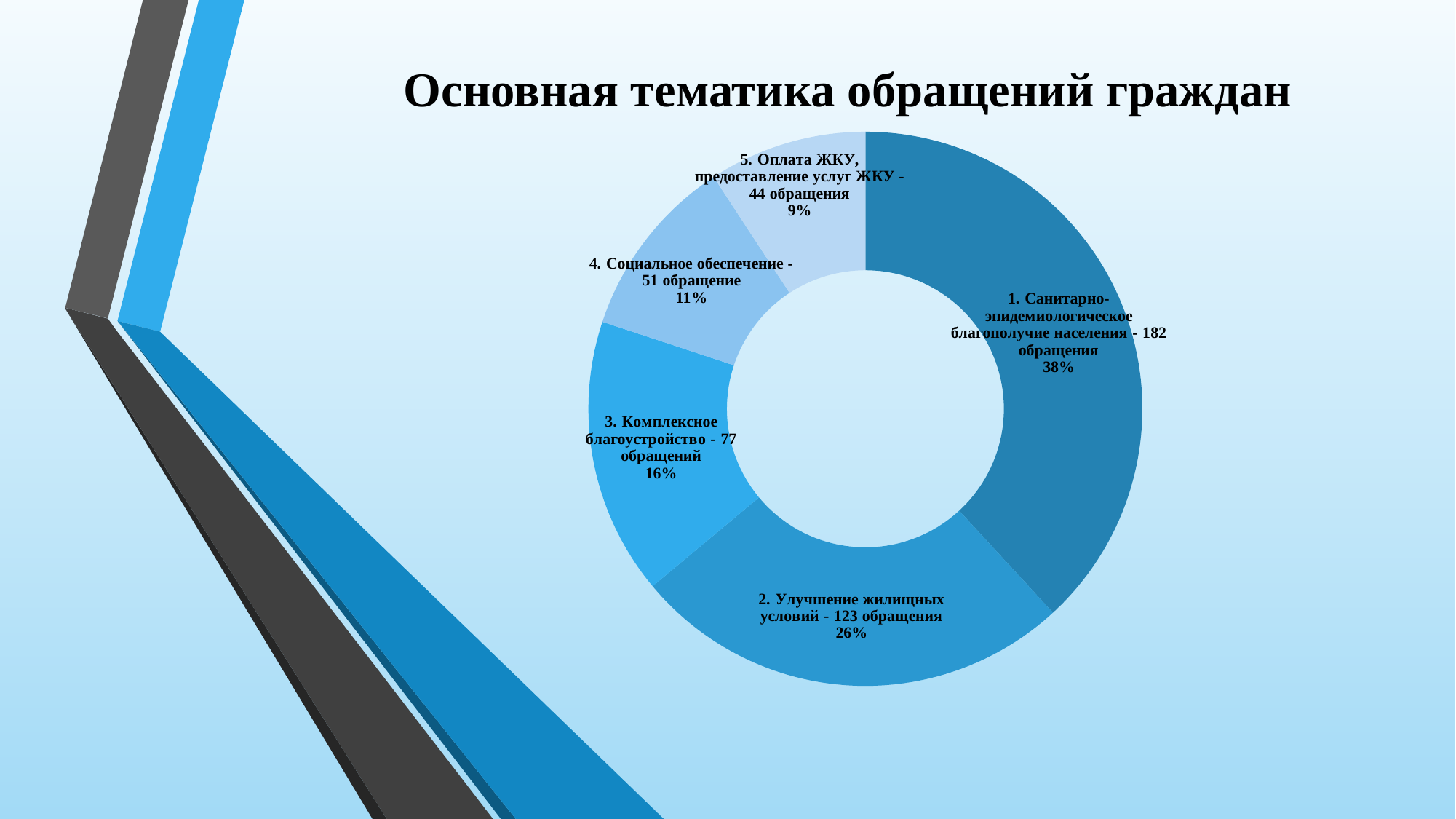
What type of chart is shown on the slide? Doughnut (pie) chart How many обращений are shown for "Комплексное благоустройство"? 77 обращений How many обращения are shown for "Санитарно-эпидемиологическое благополучие населения"? 182 обращения Which category has the smallest number of обращений? Оплата ЖКУ, предоставление услуг ЖКУ What is the title of the chart? Основная тематика обращений граждан What share of the chart does "Социальное обеспечение" represent? 11% What is the difference in обращения between "Санитарно-эпидемиологическое благополучие населения" and "Улучшение жилищных условий"? 59 Which category has the largest number of обращений? Санитарно-эпидемиологическое благополучие населения How many обращения are shown for "Улучшение жилищных условий"? 123 обращения Which has more обращений: "Комплексное благоустройство" or "Социальное обеспечение"? Комплексное благоустройство How many categories (slices) does the chart show? 5 What share of the chart does "Оплата ЖКУ, предоставление услуг ЖКУ" represent? 9%